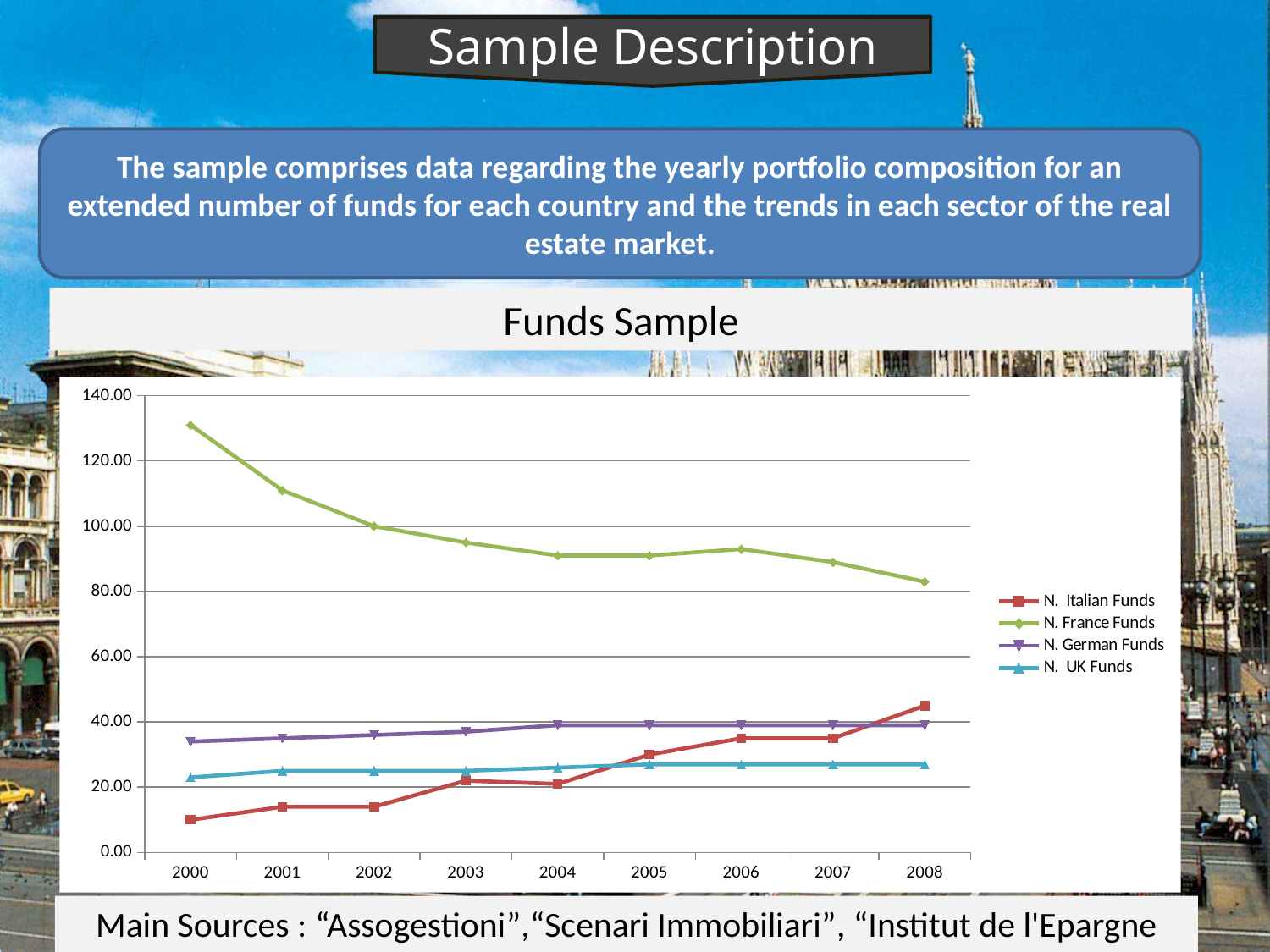
Which series has the highest value in 2000? N. France Funds How many years are shown on the x axis of the Funds Sample chart? 9 In 2008, which is larger: N. Italian Funds or N. German Funds? N. Italian Funds What kind of chart is the Funds Sample chart? line chart Does the N. Italian Funds line rise or fall from 2000 to 2008? rise Does the N. France Funds line rise or fall from 2000 to 2008? fall Is the value for N. Italian Funds in 2000 greater or less than 20.00? less How many series does the legend of the Funds Sample chart list? 4 Is the value for N. France Funds in 2000 greater or less than 120.00? greater Which series has the lowest value in 2000? N. Italian Funds Is the value for N. UK Funds in 2008 greater or less than 20.00? greater